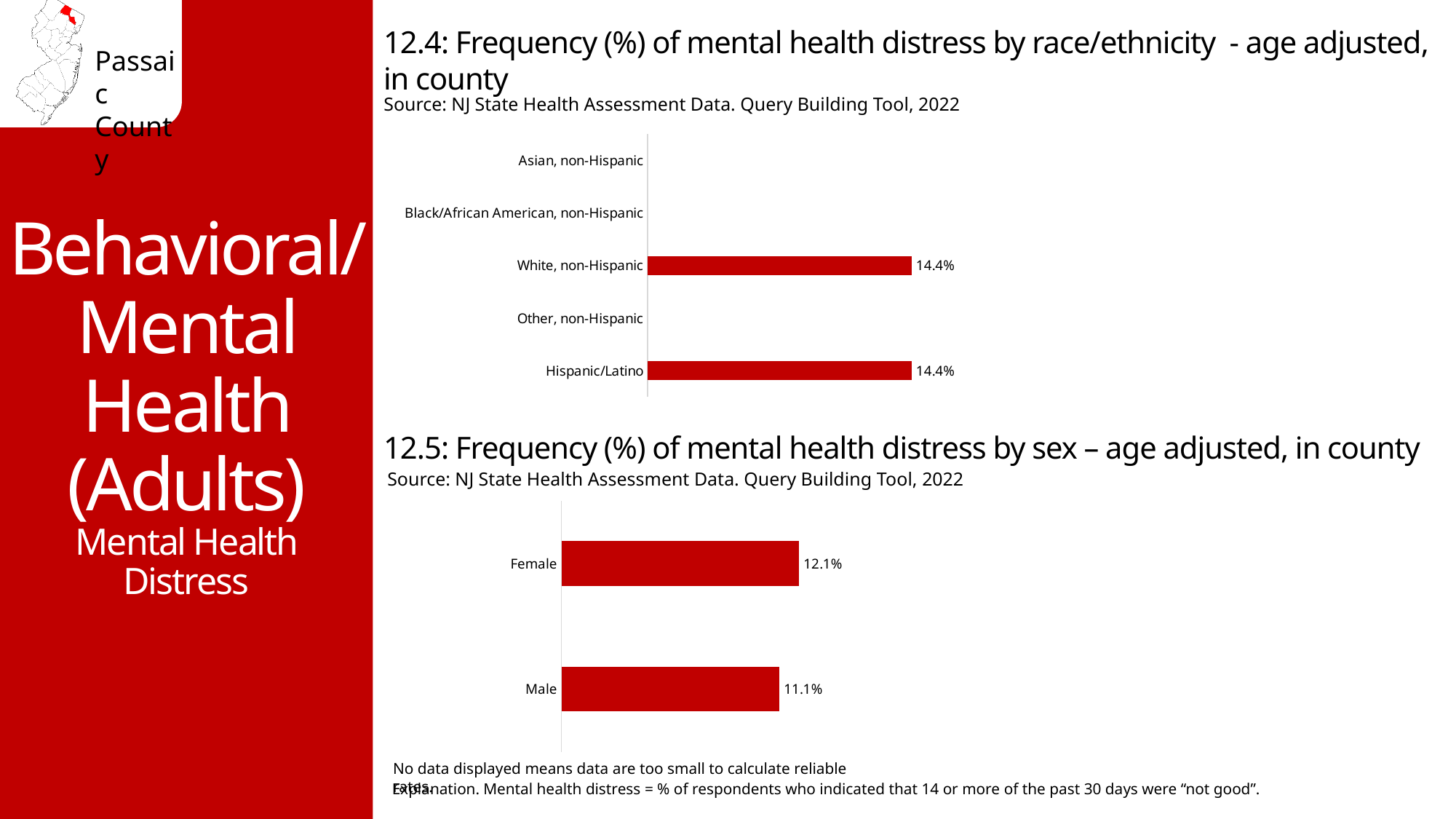
In chart 12.4 (mental health distress by race/ethnicity), what is the difference between the White, non-Hispanic and Hispanic/Latino values? 0% In chart 12.4 (mental health distress by race/ethnicity), how many categories have a bar displayed? 2 In chart 12.5 (mental health distress by sex), how many categories are shown? 2 What is the source cited for chart 12.5 (mental health distress by sex)? NJ State Health Assessment Data. Query Building Tool, 2022 What kind of chart is chart 12.4 (mental health distress by race/ethnicity)? Bar chart In chart 12.4 (mental health distress by race/ethnicity), how many race/ethnicity categories are listed on the axis? 5 In chart 12.5 (mental health distress by sex), what is the value for Male? 11.1% In chart 12.4 (mental health distress by race/ethnicity), what is the value for Hispanic/Latino? 14.4% In chart 12.5 (mental health distress by sex), what is the value for Female? 12.1% In chart 12.4 (mental health distress by race/ethnicity), what is the value for White, non-Hispanic? 14.4% In chart 12.5 (mental health distress by sex), what is the difference between the Female and Male values? 1.0% In chart 12.5 (mental health distress by sex), which category has the higher value? Female